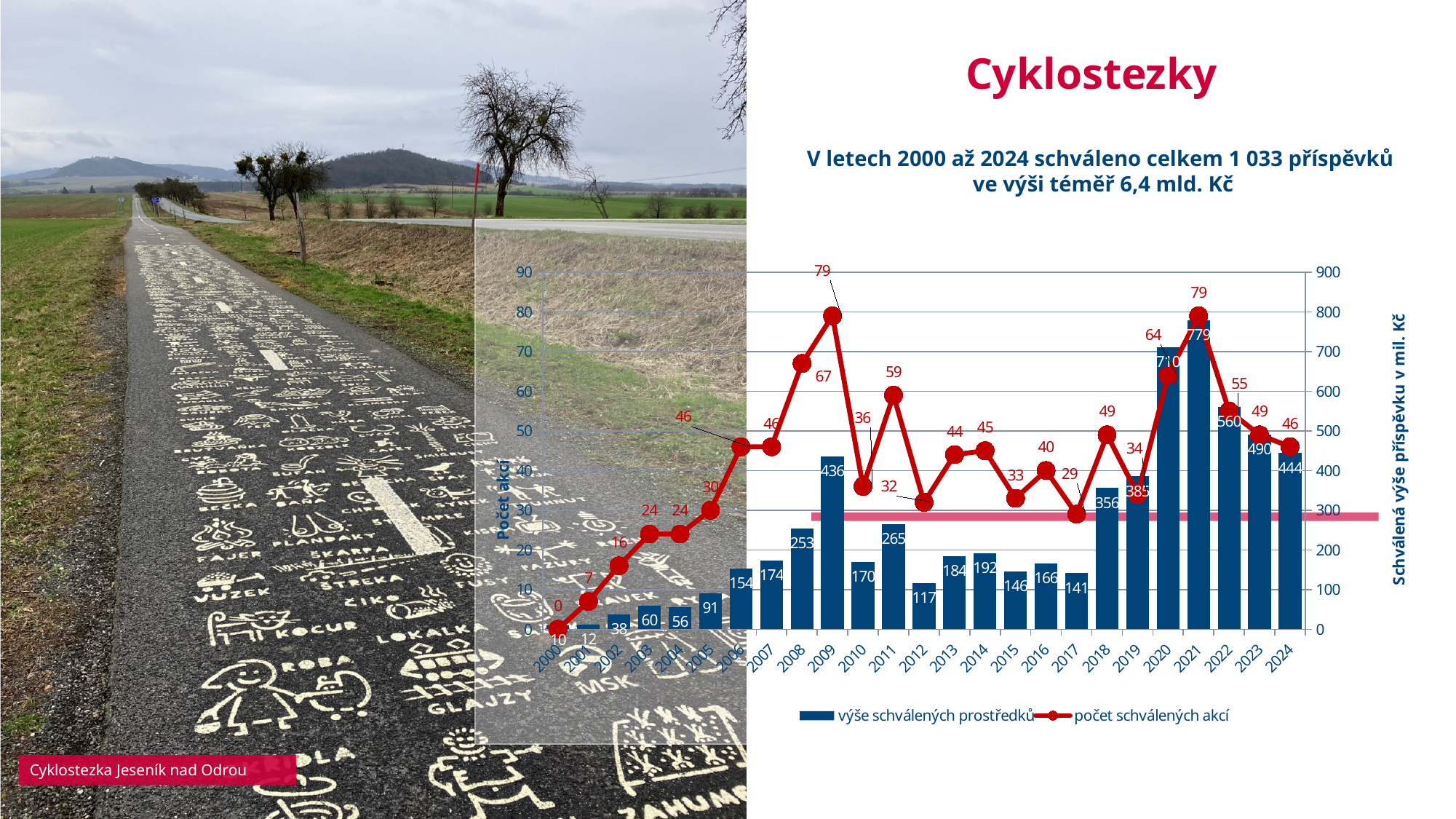
What is the difference between výše schválených prostředků in 2020 and in 2019? 325 How many schválených akcí were there in 2009? 79 Which year has the highest value of výše schválených prostředků? 2021 Did the number of schválených akcí rise or fall from 2021 to 2024? Fall How many series does the chart legend list? 2 What is the label of the right-hand vertical axis of the chart? Schválená výše příspěvku v mil. Kč How many years are shown on the x axis of the chart? 25 What was the value of výše schválených prostředků in 2012? 117 Which year has the lowest value of výše schválených prostředků? 2000 What was the value of výše schválených prostředků in 2021? 779 Which year had more schválených akcí, 2011 or 2010? 2011 What kind of chart is shown on the slide? Combined bar and line chart